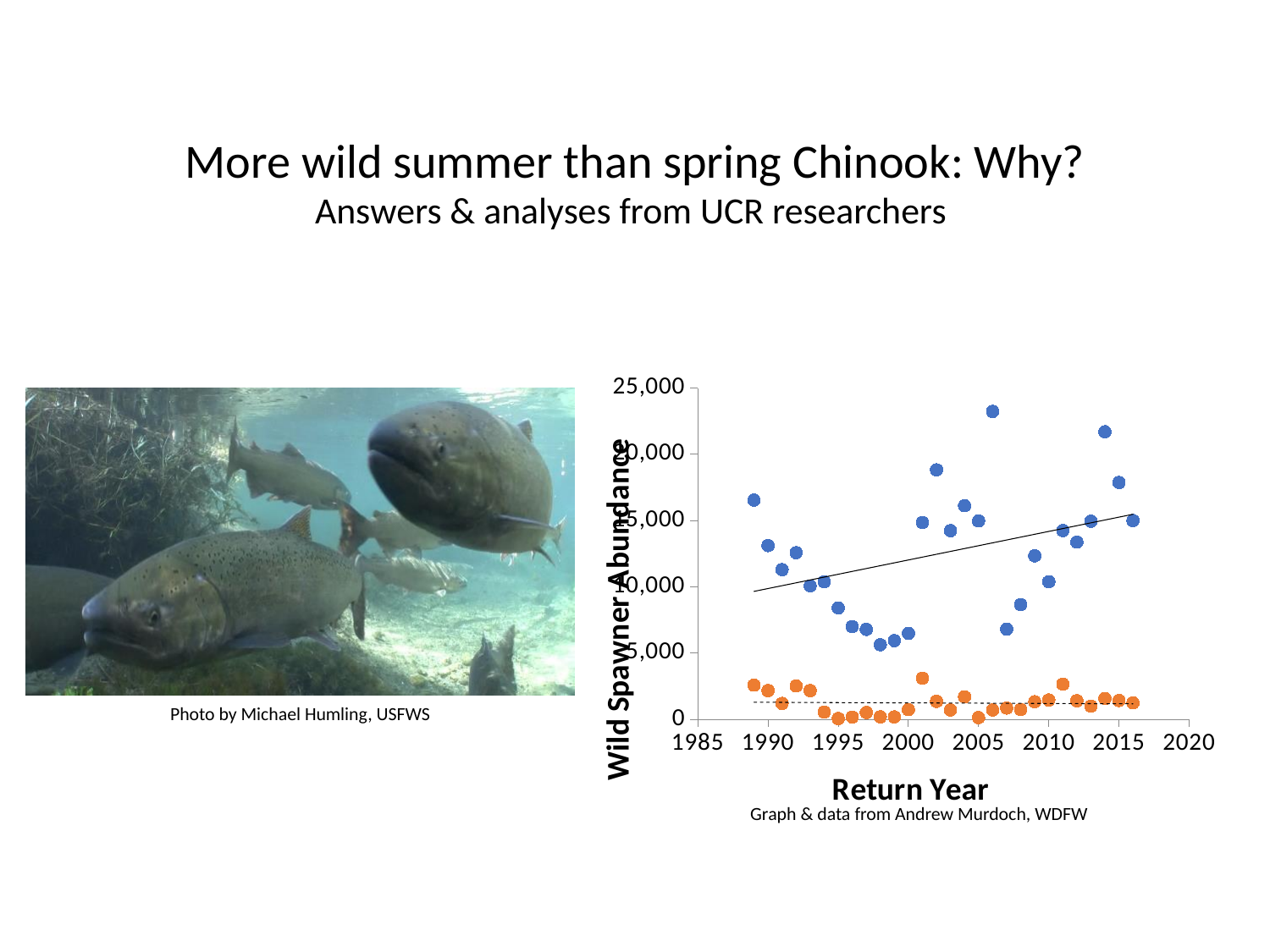
For return year 2006, which series has the larger value, blue or orange? blue What kind of chart is shown on the slide? scatter chart What is the highest value shown on the y axis of the chart? 25,000 Is the orange series value for return year 2001 greater or less than 5,000? less What is the title of the x axis of the chart? Return Year What is the title of the y axis of the chart? Wild Spawner Abundance In which return year does the blue series reach its highest value? 2006 Does the fitted trend line for the blue series rise or fall from 1989 to 2016? rise Is the blue series value for return year 2006 greater or less than 20,000? greater Is the blue series value for return year 2002 greater or less than 15,000? greater